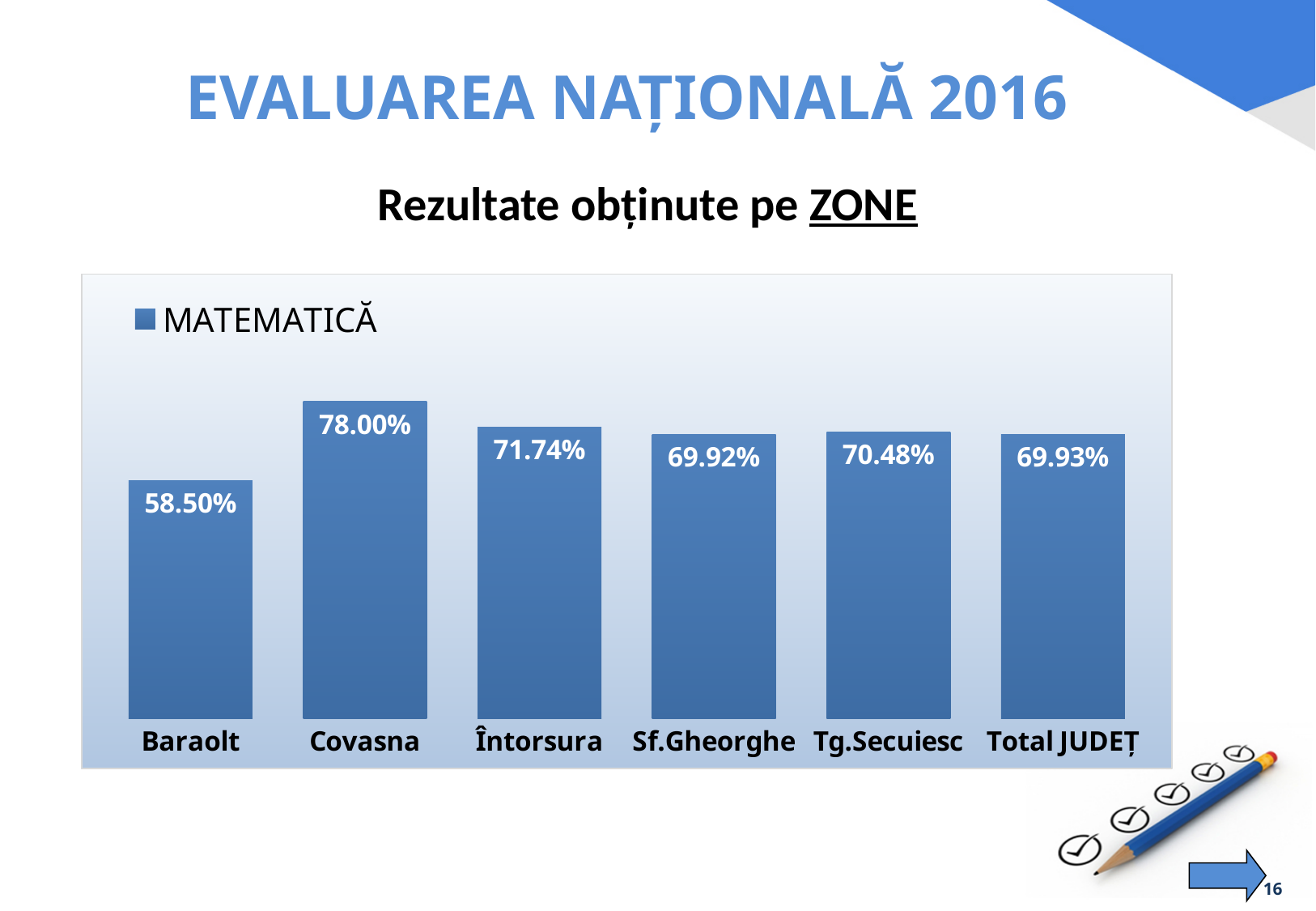
Which zone has the highest MATEMATICĂ value? Covasna How many series does the chart legend list? 1 What kind of chart is shown on the slide? Bar chart What is the MATEMATICĂ value for Întorsura? 71.74% What is the difference between the MATEMATICĂ values for Întorsura and Sf.Gheorghe? 1.82% Which zone has the lowest MATEMATICĂ value? Baraolt How many zones are shown on the x axis of the chart? 6 Which has a larger MATEMATICĂ value, Tg.Secuiesc or Sf.Gheorghe? Tg.Secuiesc What is the difference between the MATEMATICĂ values for Covasna and Baraolt? 19.50% What is the MATEMATICĂ value for Baraolt? 58.50% What is the MATEMATICĂ value for Covasna? 78.00% What is the MATEMATICĂ value for Total JUDEȚ? 69.93%